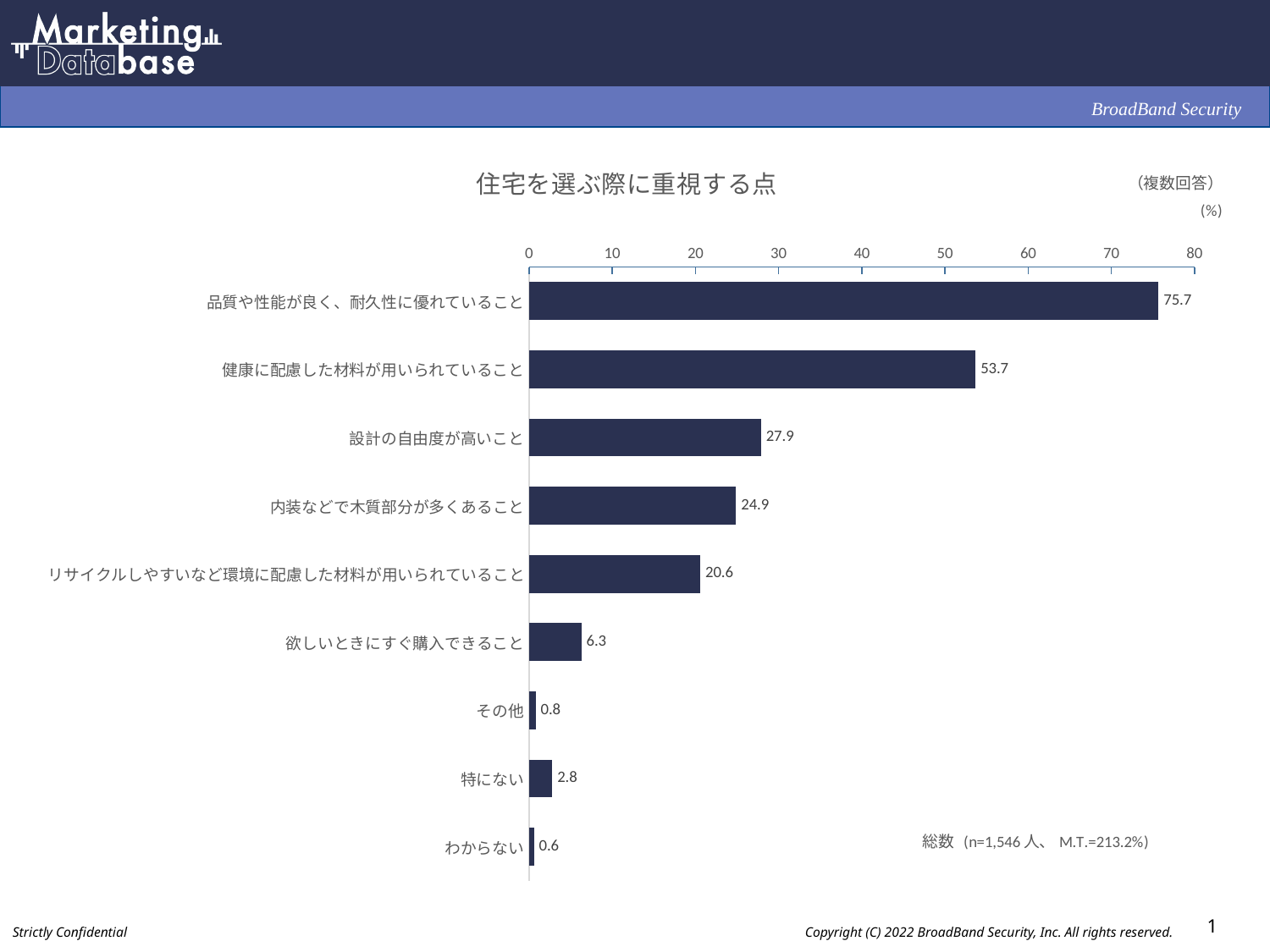
What kind of chart is shown on the slide? bar chart What is the value for リサイクルしやすいなど環境に配慮した材料が用いられていること? 20.6 What is the value for 特にない? 2.8 What is the difference between the values for 設計の自由度が高いこと and 内装などで木質部分が多くあること? 3.0 Which is larger, the value for 欲しいときにすぐ購入できること or the value for 特にない? 欲しいときにすぐ購入できること What is the value for 品質や性能が良く、耐久性に優れていること? 75.7 How many categories are shown in the chart? 9 What is the value for 健康に配慮した材料が用いられていること? 53.7 Which category has the lowest value? わからない What is the title of the chart? 住宅を選ぶ際に重視する点 Which category has the highest value? 品質や性能が良く、耐久性に優れていること Is the value for 健康に配慮した材料が用いられていること greater or less than 50? greater